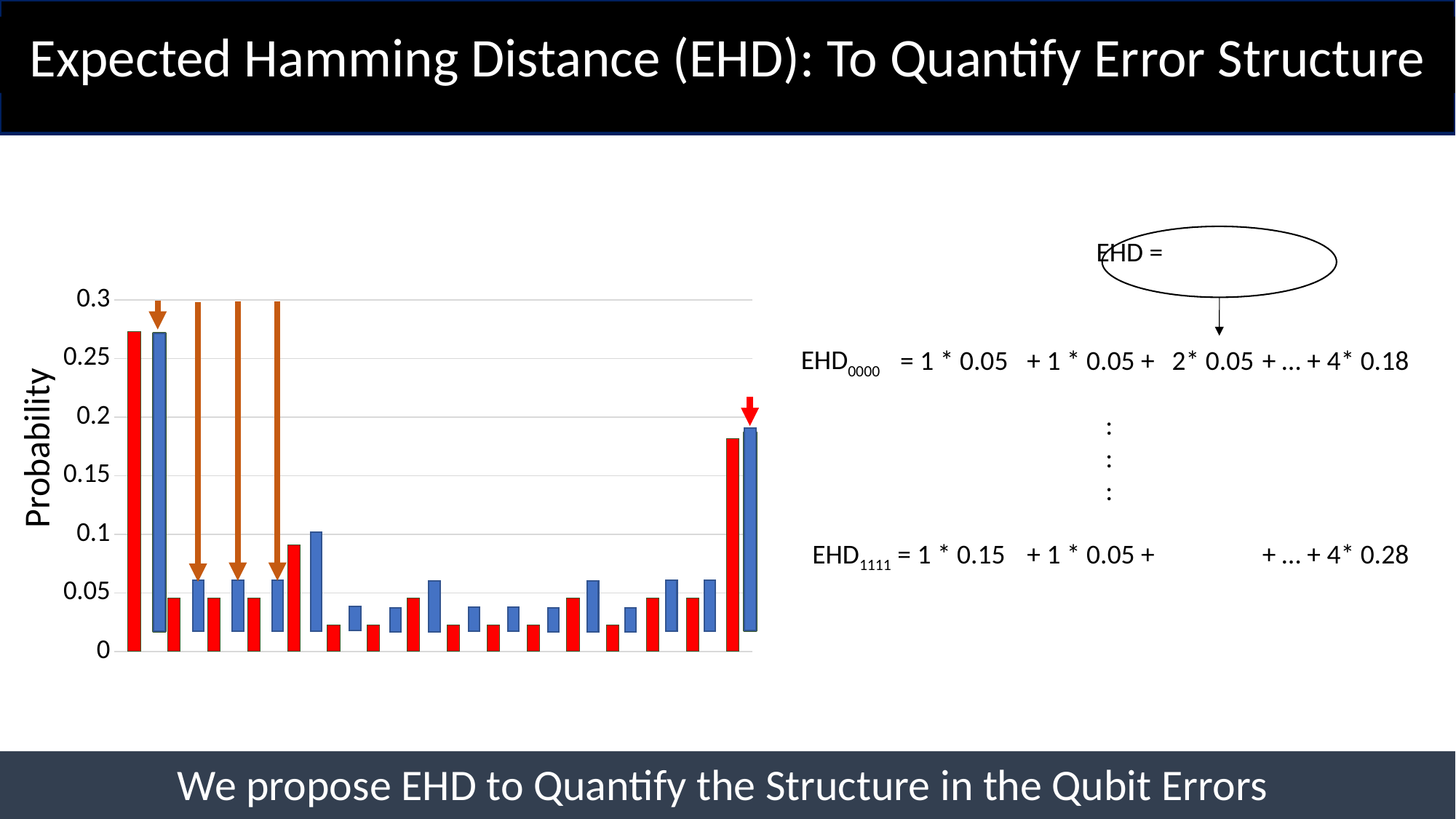
Among the red bars, which position has the highest value? the leftmost (first) bar How many blue bars are plotted in the chart? 16 Is the value of the rightmost red bar greater or less than 0.2? less What is the highest value shown on the vertical axis of the chart? 0.3 What kind of chart is shown on the left of the slide? bar chart How many differently coloured bar series are plotted in the chart? 2 What is the label on the vertical axis of the chart? Probability Is the value of the leftmost red bar greater or less than 0.25? greater Which is larger, the leftmost red bar or the rightmost red bar? the leftmost red bar How many red bars are plotted in the chart? 16 Is the value of the rightmost blue bar greater or less than 0.15? greater Which is larger, the leftmost blue bar or the rightmost blue bar? the leftmost blue bar